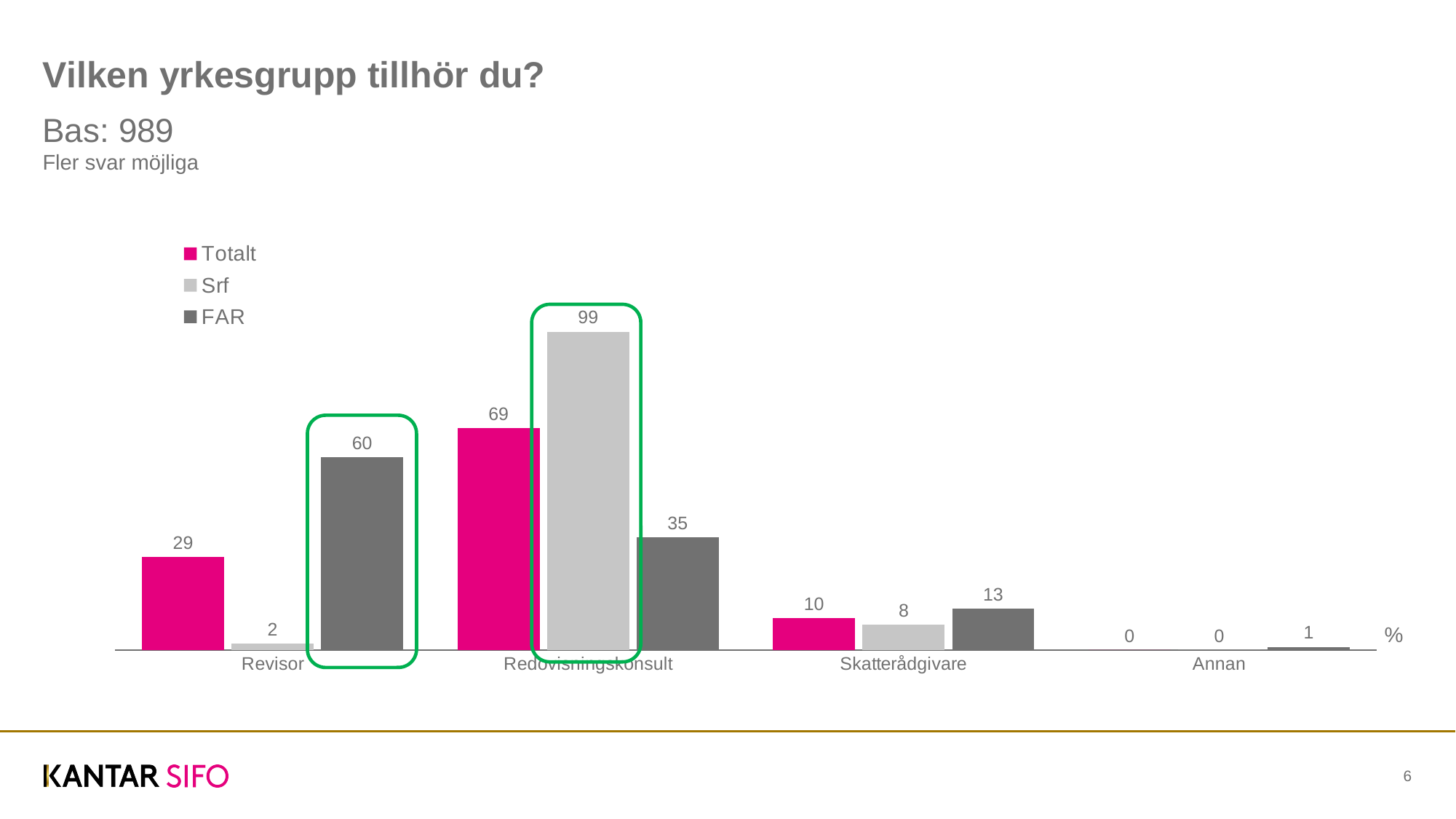
Which category has the highest FAR value? Revisor What is the Srf value for Redovisningskonsult? 99 Which category has the lowest Totalt value? Annan How many series does the legend list? 3 What is the Totalt value for Revisor? 29 How many categories are shown on the x axis? 4 What is the Srf value for Annan? 0 What is the base (Bas) stated on the slide? 989 What is the difference between the FAR value and the Srf value for Revisor? 58 What is the FAR value for Skatterådgivare? 13 Which is larger for Redovisningskonsult, the Totalt value or the FAR value? Totalt What kind of chart is shown on the slide? Bar chart